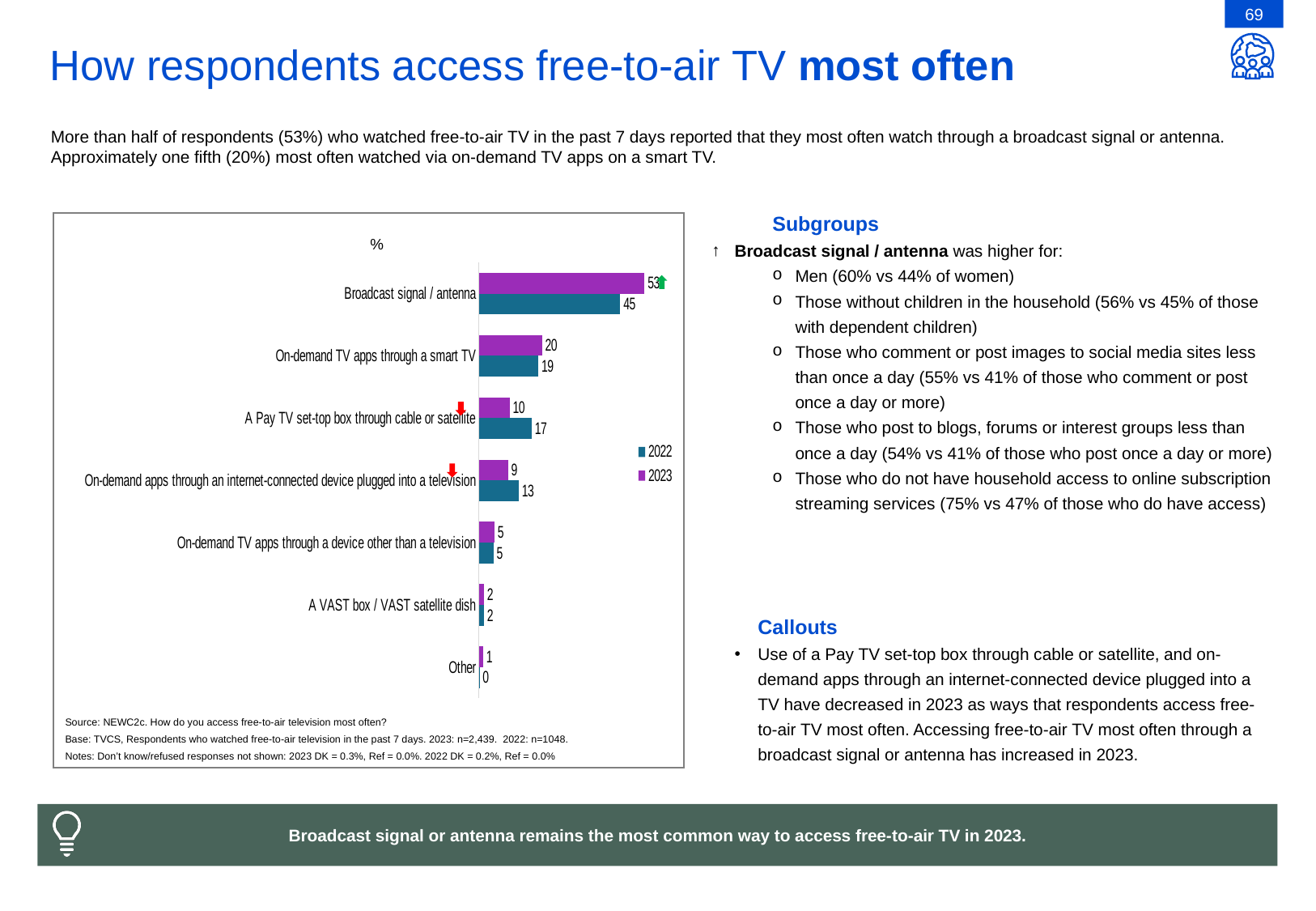
What is the 2022 value for A Pay TV set-top box through cable or satellite? 17 For On-demand apps through an internet-connected device plugged into a television, which year has the larger value, 2022 or 2023? 2022 What is the 2022 value for Other? 0 Which category has the highest 2023 value? Broadcast signal / antenna What is the 2023 value for On-demand apps through an internet-connected device plugged into a television? 9 How many series does the legend list? 2 How many categories are shown in the chart? 7 Which category has the lowest 2022 value? Other What is the difference between the 2023 and 2022 values for Broadcast signal / antenna? 8 What is the 2023 value for Broadcast signal / antenna? 53 What kind of chart is shown on the slide? Bar chart What is the difference between the 2022 and 2023 values for A Pay TV set-top box through cable or satellite? 7